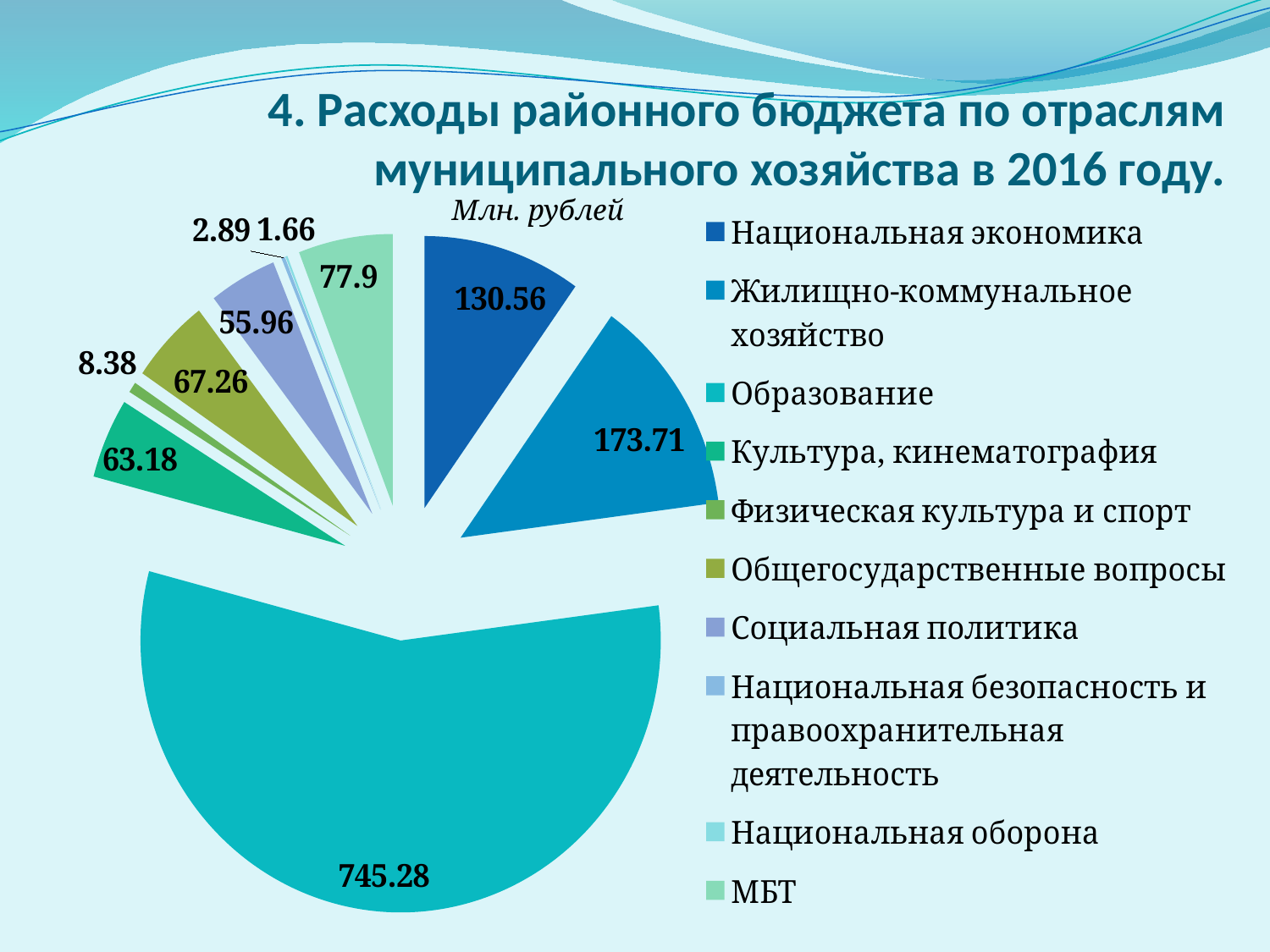
What is the difference between Жилищно-коммунальное хозяйство and Национальная экономика? 43.15 What is the value for Образование? 745.28 What type of chart is shown on the slide? pie chart How many categories does the legend list? 10 What is the value for Национальная экономика? 130.56 Which category has the largest value? Образование What unit is stated above the chart? Млн. рублей Which is larger, Культура, кинематография or Общегосударственные вопросы? Общегосударственные вопросы Which category has the smallest value? Национальная оборона What is the value for Национальная оборона? 1.66 What is the value for Жилищно-коммунальное хозяйство? 173.71 What is the value for МБТ? 77.9